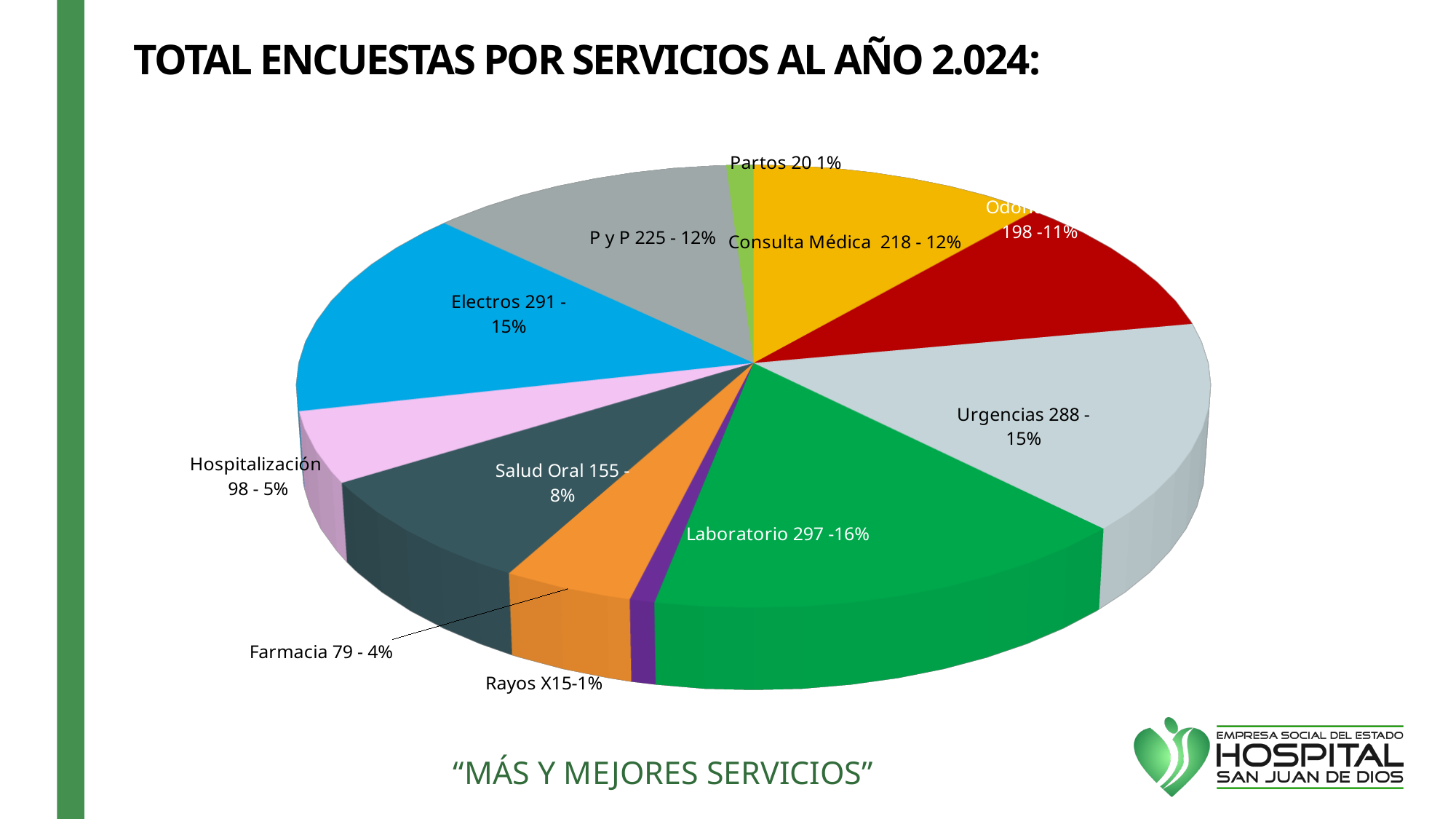
What is the title of the chart? TOTAL ENCUESTAS POR SERVICIOS AL AÑO 2.024: What kind of chart is shown on the slide? pie chart Which service has the smallest number of surveys? Rayos X How many slices does the pie chart have? 11 What percentage share does the Urgencias slice have? 15% Which service has the largest number of surveys? Laboratorio How many surveys does the Laboratorio slice represent? 297 What is the difference in surveys between Hospitalización and Farmacia? 19 What percentage share does Salud Oral have? 8% Which has more surveys, Consulta Médica or P y P? P y P What is the difference in surveys between Electros and Urgencias? 3 How many surveys does Farmacia have? 79